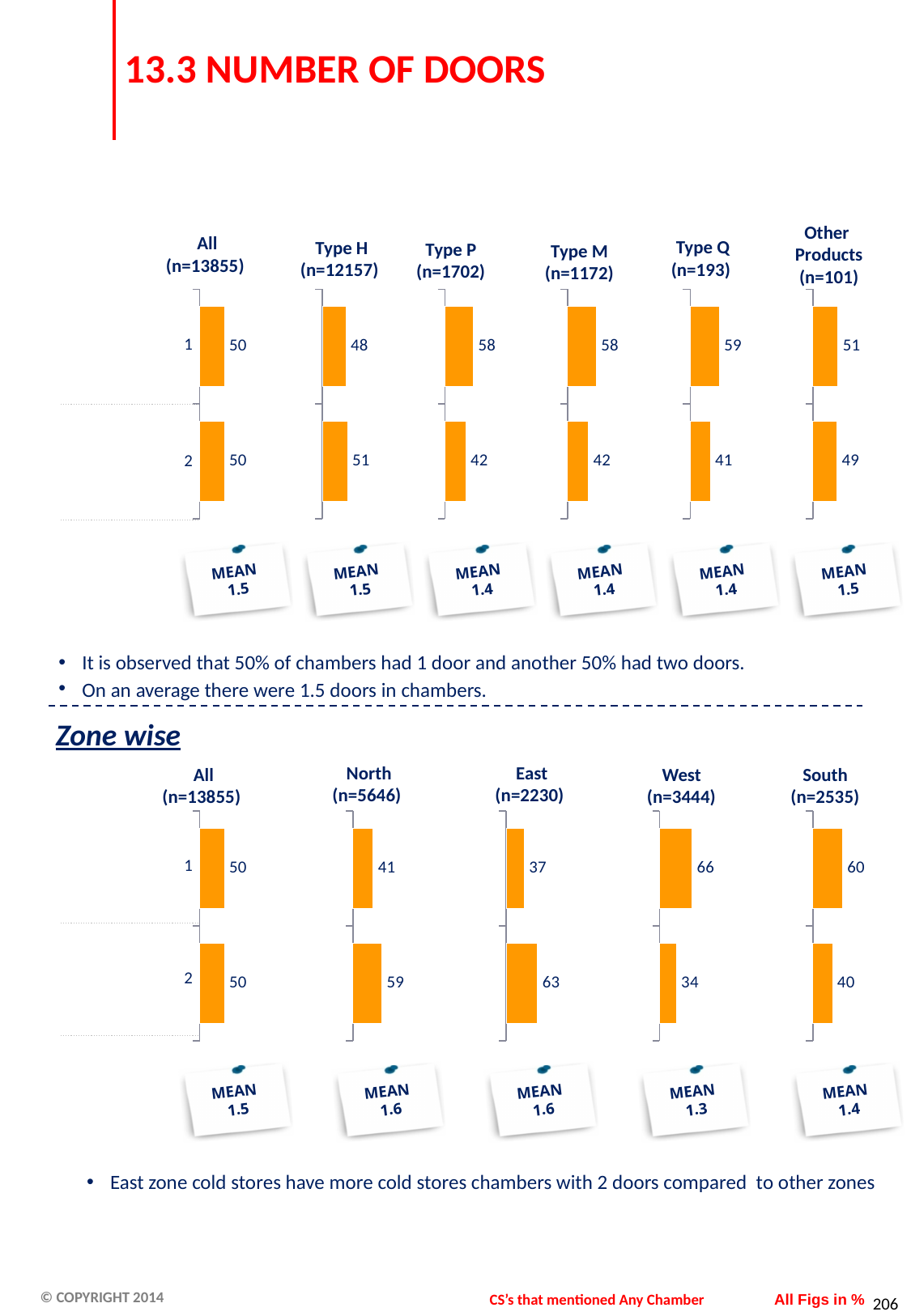
In the Zone wise charts, which zone has the lowest value for 1 door? East In the Zone wise charts, what is the difference between the 1-door values for West and North? 25 In the Zone wise charts, which zone has the highest value for 2 doors? East In the Zone wise charts, what is the mean number of doors shown for West? 1.3 In the top set of charts, what is the mean number of doors shown for Type M? 1.4 In the top set of charts, what percentage of Type Q chambers have 2 doors? 41 What kind of chart is used to show the number of doors on this slide? Bar chart In the Zone wise charts, what is the value for 2 doors in the East zone? 63 In the top set of charts, what percentage of Type H chambers have 1 door? 48 In the Zone wise charts, is the 2-door value larger for North or for South? North In the Zone wise charts, what is the value for 1 door in the West zone? 66 In the top set of charts, what is the difference between the 1-door and 2-door values for Type P? 16